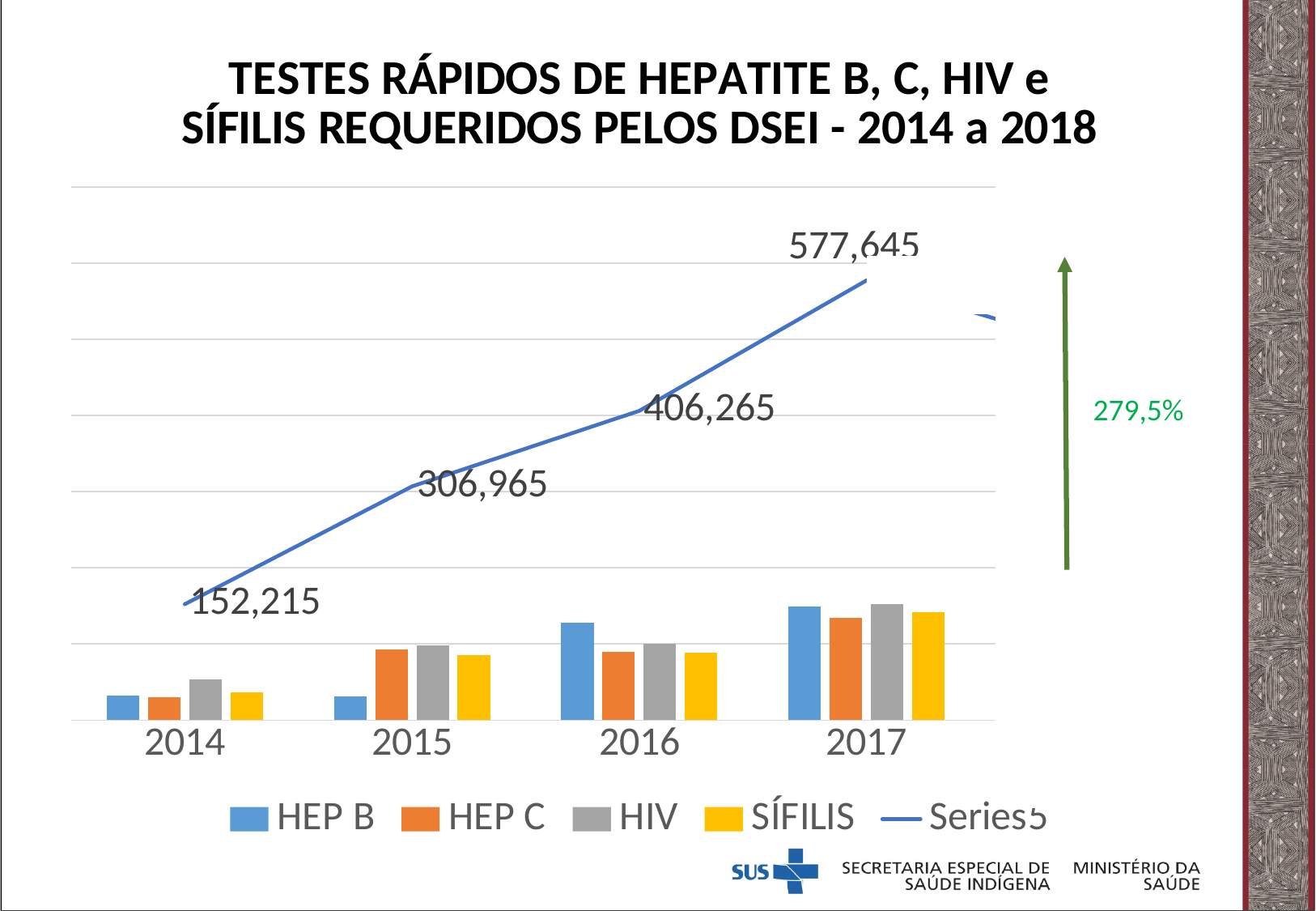
Does the line series rise or fall from 2014 to 2017? rises How many years are shown on the x axis? 4 What is the difference between the line series values for 2017 and 2014? 425,430 What value does the line series show for 2017? 577,645 In which year does the line series have its lowest value? 2014 What is the difference between the line series values for 2016 and 2015? 99,300 How many series does the legend list? 5 Which series has the tallest bar in 2016? HEP B In which year does the line series reach its highest value? 2017 What value does the line series show for 2014? 152,215 What value does the line series show for 2015? 306,965 What value does the line series show for 2016? 406,265